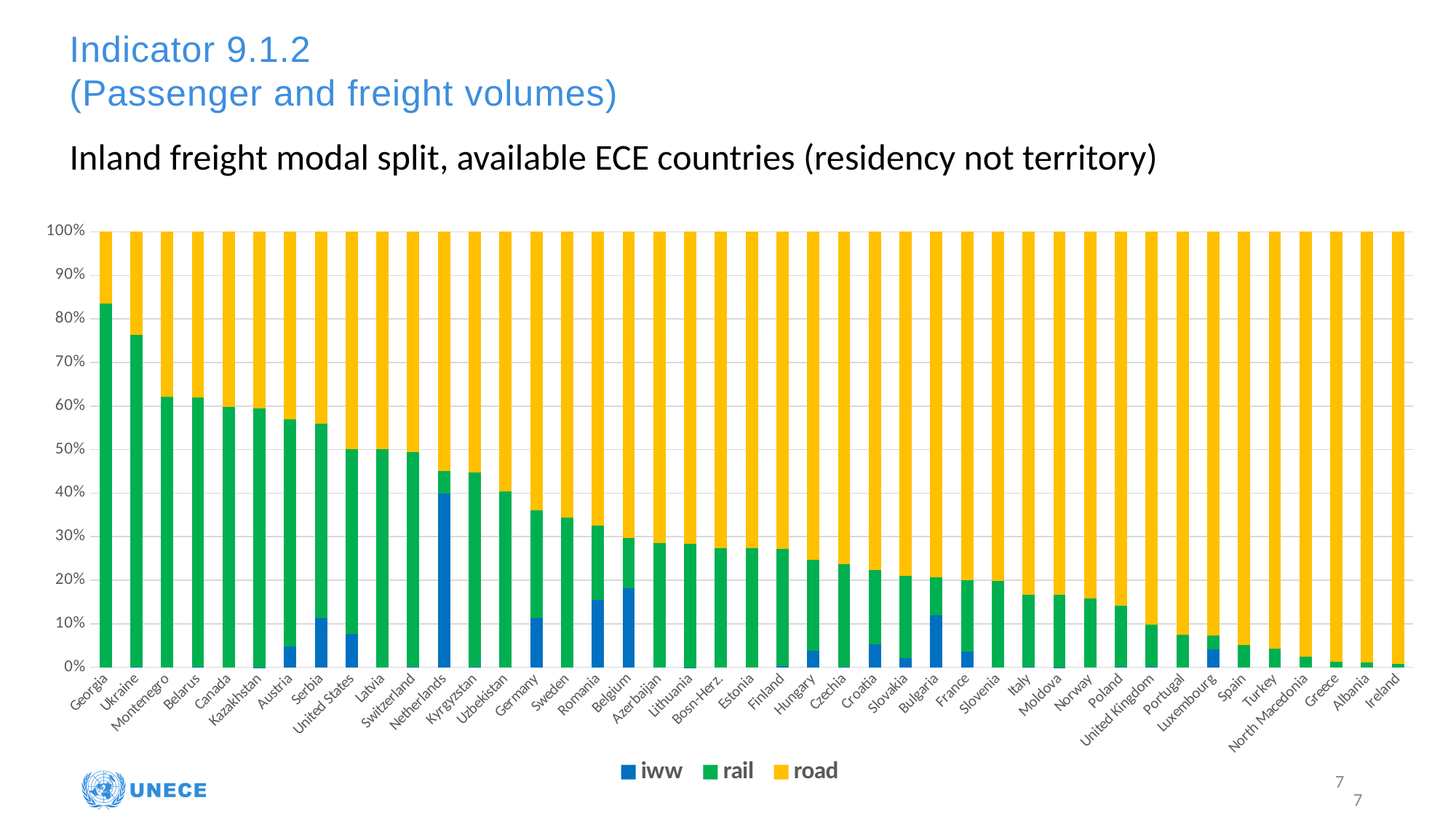
What kind of chart is shown on the slide? Stacked bar chart How many series does the legend list? 3 Which country has the largest inland waterways (iww) share? Netherlands Is the rail share for Ireland greater or less than 10%? less Which has a larger rail share, Georgia or Ukraine? Georgia Is the iww share for the Netherlands greater or less than 30%? greater Which country has the highest rail share of inland freight? Georgia Moving from left to right along the x axis, does the road share rise or fall? Rise Is the rail share for Georgia greater or less than 80%? greater How many countries are shown on the x axis? 43 Which colour represents road in the legend? Yellow